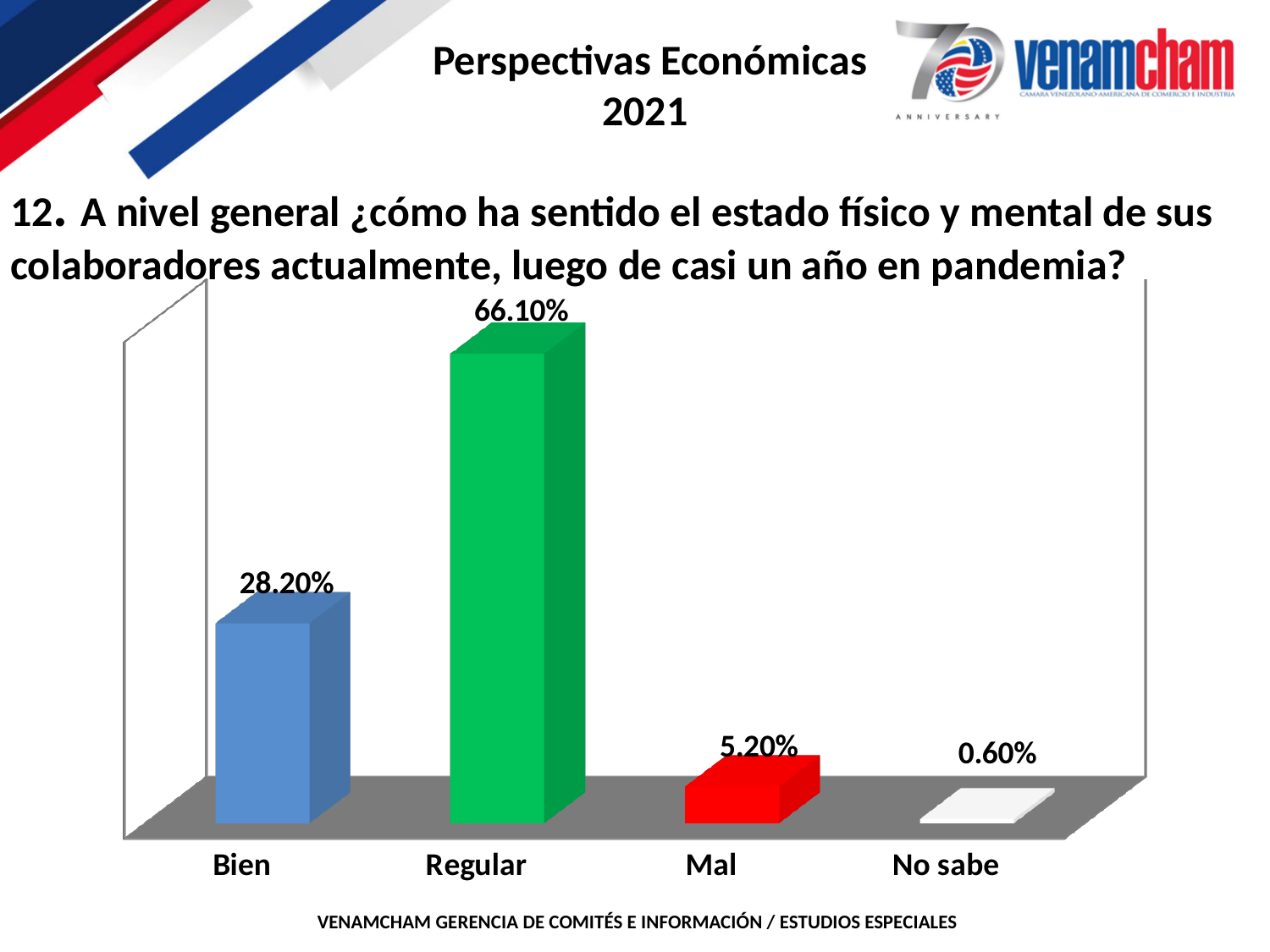
What is the difference between the values for Regular and Bien? 37.90% Which is larger, the value for Bien or the value for Mal? Bien What kind of chart is shown on the slide? Bar chart What is the value for Bien? 28.20% What is the value for Mal? 5.20% What is the difference between the values for Mal and No sabe? 4.60% Which category has the lowest value? No sabe Which category has the highest value? Regular What is the value for Regular? 66.10% What colour is the bar for Regular? Green How many categories are shown in the chart? 4 What is the value for No sabe? 0.60%